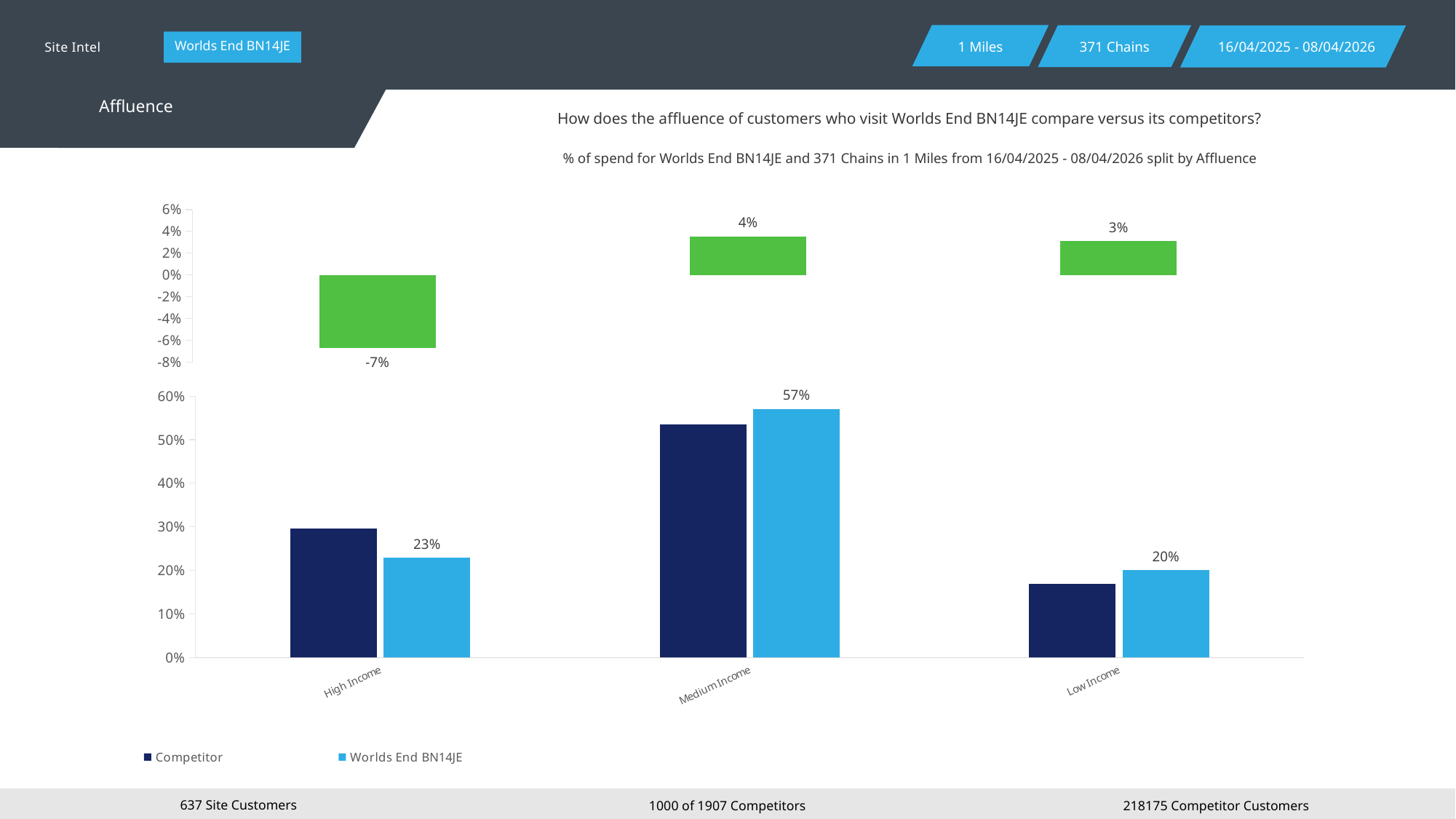
In the bottom chart, which is larger for High Income: the Competitor value or the Worlds End BN14JE value? Competitor In the bottom chart, what is the Worlds End BN14JE value for High Income? 23% In the bottom chart, what is the difference between the Worlds End BN14JE values for Medium Income and High Income? 34% In the bottom chart, is the Competitor value for High Income greater or less than 20%? greater In the top chart, what is the value for Low Income? 3% In the top chart, which category has the lowest value? High Income In the bottom chart, what is the Worlds End BN14JE value for Low Income? 20% In the bottom chart, what is the Worlds End BN14JE value for Medium Income? 57% In the top chart, which category has the highest value? Medium Income In the top chart, what is the value for Medium Income? 4% In the top chart, what is the value for High Income? -7% How many series does the legend of the bottom chart list? 2